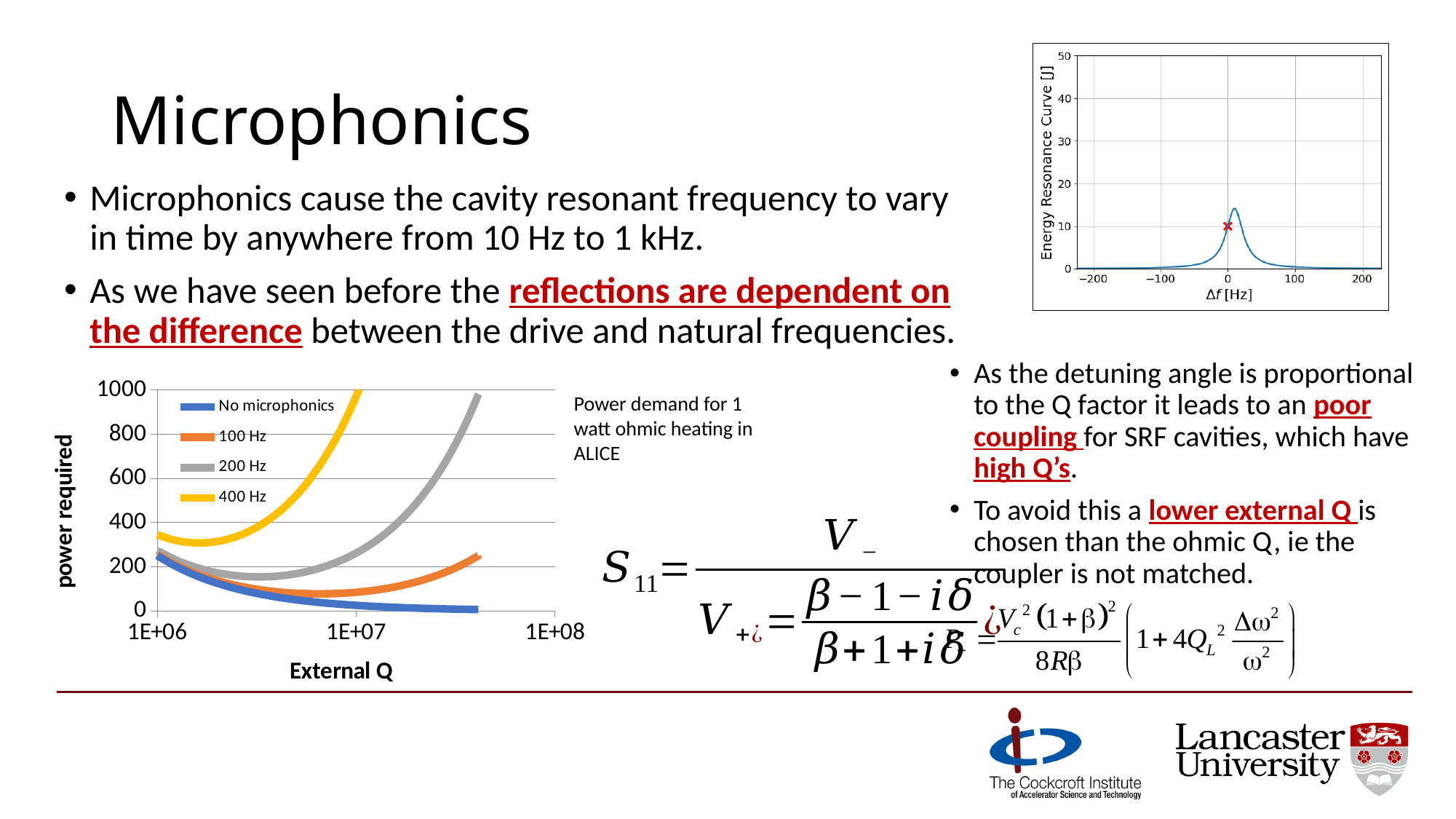
In the bottom-left chart, is the value of the '400 Hz' series at External Q = 1E+06 greater or less than 200? greater In the top-right chart, is the peak of the Energy Resonance Curve greater or less than 20? less In the bottom-left chart, how many series does the legend list? 4 In the bottom-left chart, which series is drawn in yellow? 400 Hz In the bottom-left chart, does the 'No microphonics' series rise or fall as External Q increases? fall In the bottom-left chart, is the lowest point of the '100 Hz' series greater or less than 200? less In the top-right chart, what is the label of the x axis? Δf [Hz] In the bottom-left chart, what is the label of the x axis? External Q In the bottom-left chart, at External Q = 1E+07, which series has the higher power required: '400 Hz' or 'No microphonics'? 400 Hz In the bottom-left chart, which series reaches the highest power required at External Q = 1E+07? 400 Hz What kind of chart is the bottom-left chart of power required against External Q? line chart